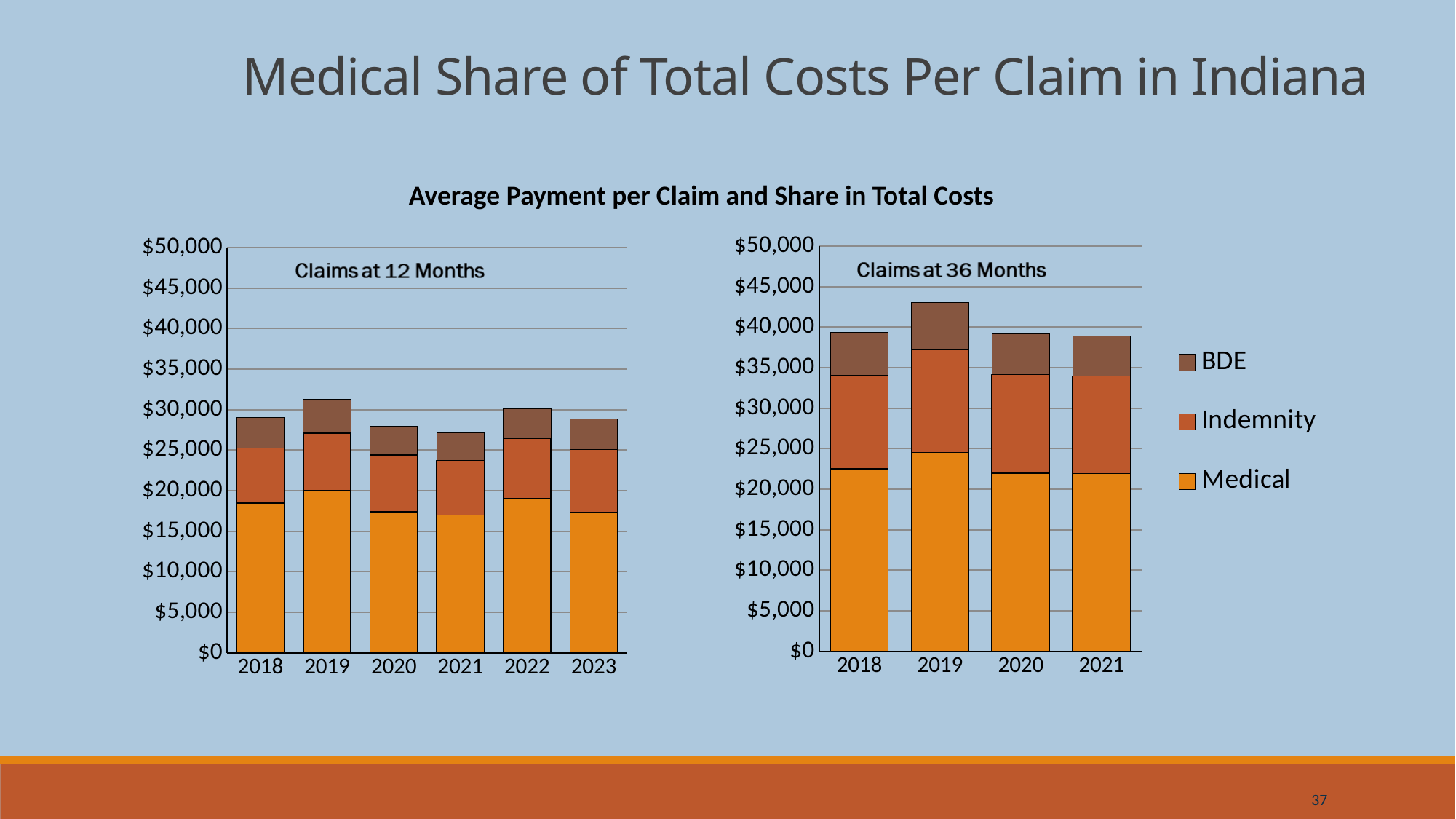
In the 'Claims at 12 Months' chart, which year has the highest total bar? 2019 How many years are shown on the x axis of the 'Claims at 36 Months' chart? 4 How many series does the legend list for the charts on this slide? 3 In the 'Claims at 36 Months' chart, which total bar is larger, 2018 or 2019? 2019 Which series is shown in the darkest brown colour at the top of each stacked bar? BDE How many years are shown on the x axis of the 'Claims at 12 Months' chart? 6 In the 'Claims at 12 Months' chart, is the total bar for 2019 greater or less than $30,000? greater In the 'Claims at 36 Months' chart, is the total bar for 2019 greater or less than $40,000? greater In the 'Claims at 36 Months' chart, is the Medical segment for 2018 greater or less than $20,000? greater What kind of chart is the 'Claims at 12 Months' chart? Stacked bar chart In the 'Claims at 36 Months' chart, which year has the highest total bar? 2019